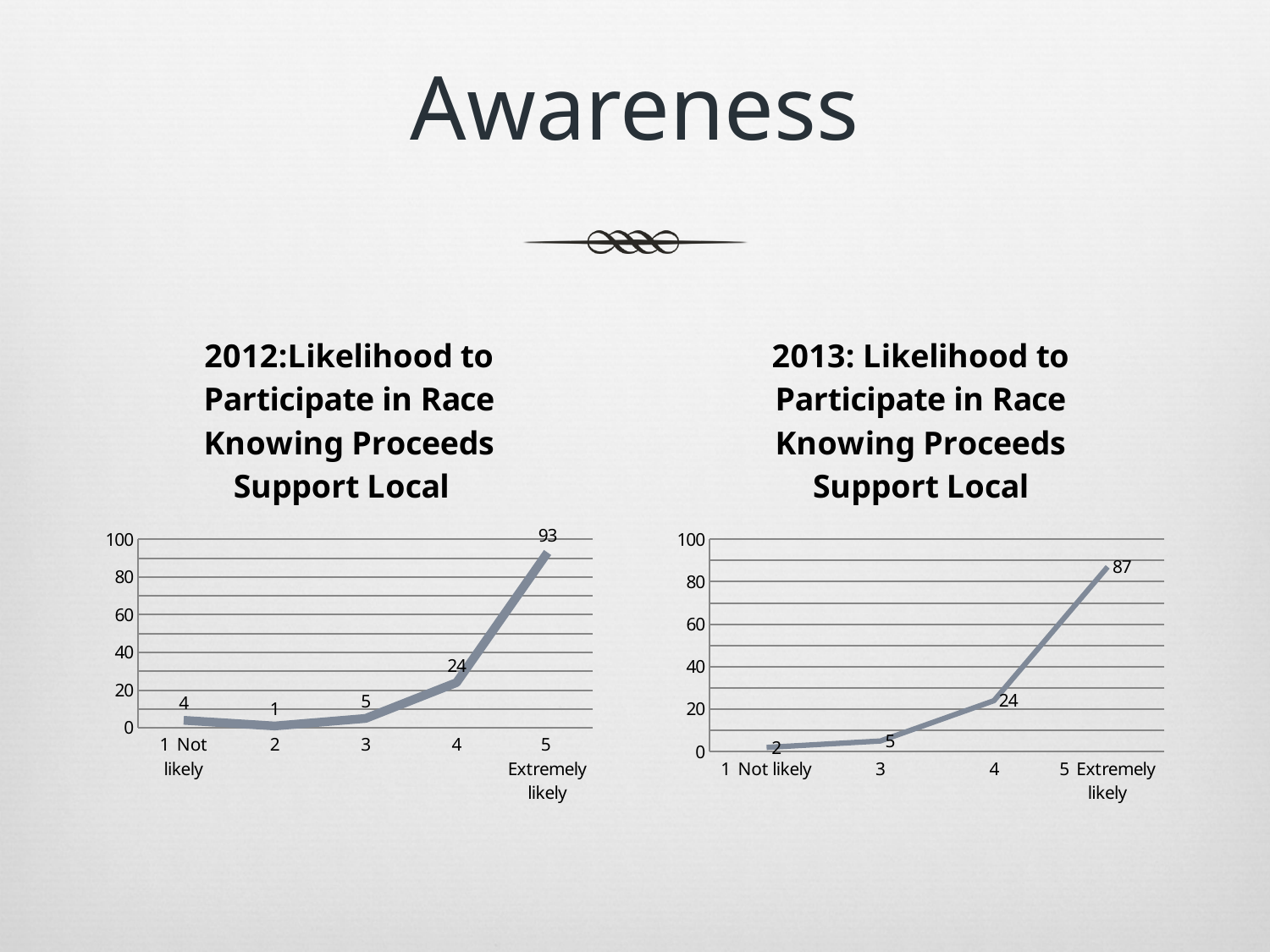
In the 2013 chart, which category has the highest value? 5 Extremely likely How many data points are plotted in the 2013 chart? 4 In the 2012 chart, what is the difference between the values for category 5 Extremely likely and category 4? 69 In the 2013 chart, what is the value for category 1 Not likely? 2 In the 2013 chart, what is the value for category 5 Extremely likely? 87 In the 2013 chart, what is the difference between the values for category 4 and category 3? 19 What type of chart is the 2012 chart? Line chart In the 2012 chart, what is the value for category 2? 1 In the 2013 chart, do the values generally rise or fall from left to right along the x axis? Rise Which is larger: the value for 5 Extremely likely in the 2012 chart or in the 2013 chart? 2012 chart In the 2012 chart, what is the value for category 5 Extremely likely? 93 In the 2012 chart, which category has the lowest value? 2